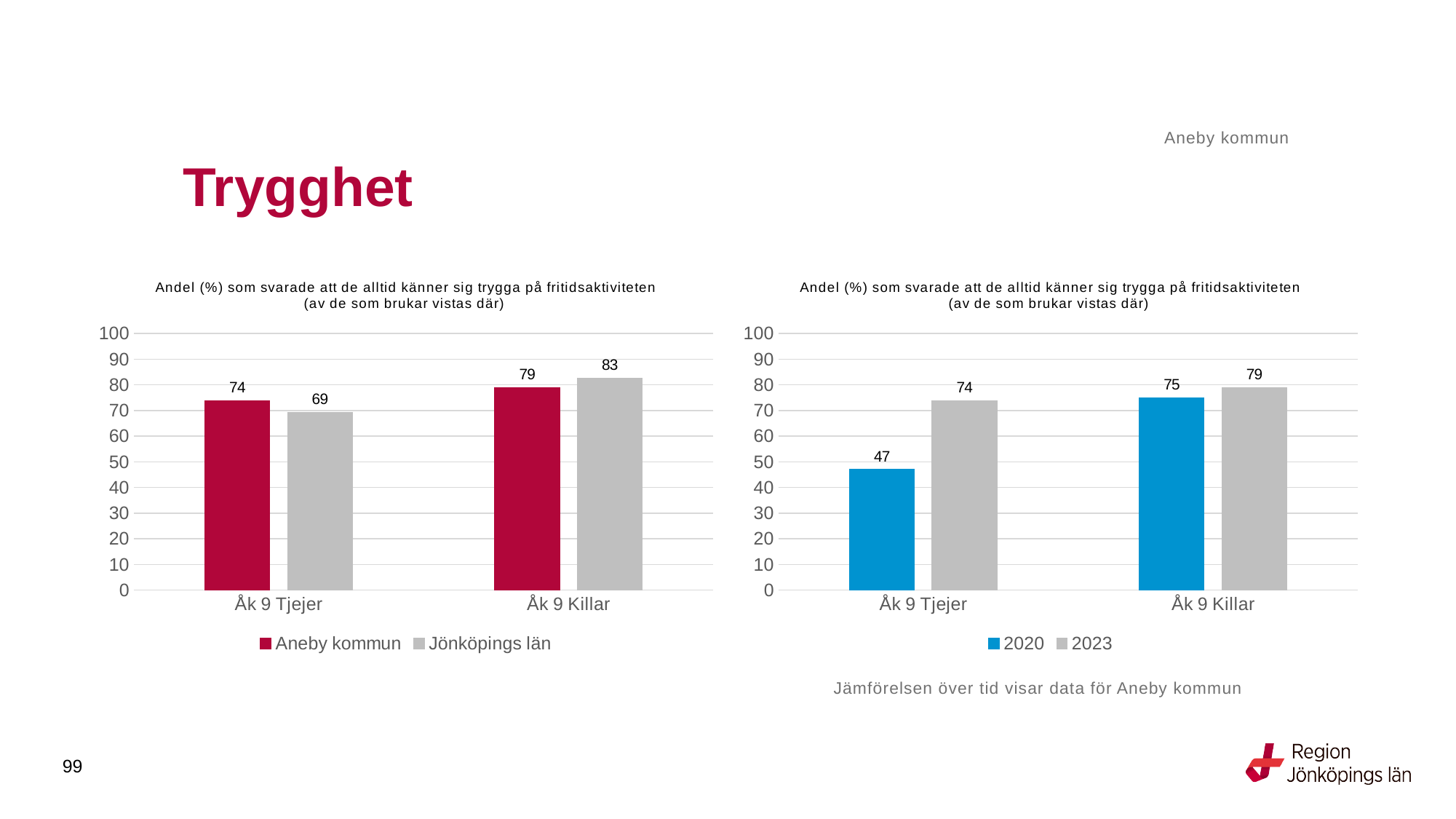
In the left chart, what is the difference between Jönköpings län and Aneby kommun for Åk 9 Killar? 4 In the left chart, which is larger for Åk 9 Tjejer: Aneby kommun or Jönköpings län? Aneby kommun What type of chart is the left chart? Bar chart In the right chart, what is the value for 2020 for Åk 9 Tjejer? 47 In the left chart, what is the value for Jönköpings län for Åk 9 Killar? 83 In the left chart, what is the value for Aneby kommun for Åk 9 Tjejer? 74 In the right chart, what is the difference between the 2023 and 2020 values for Åk 9 Tjejer? 27 In the left chart, which category has the highest value for Jönköpings län? Åk 9 Killar In the right chart, what colour are the 2020 bars? Blue In the right chart, what is the value for 2023 for Åk 9 Killar? 79 In the right chart, how many series does the legend list? 2 In the right chart, which bar has the lowest value? 2020 for Åk 9 Tjejer